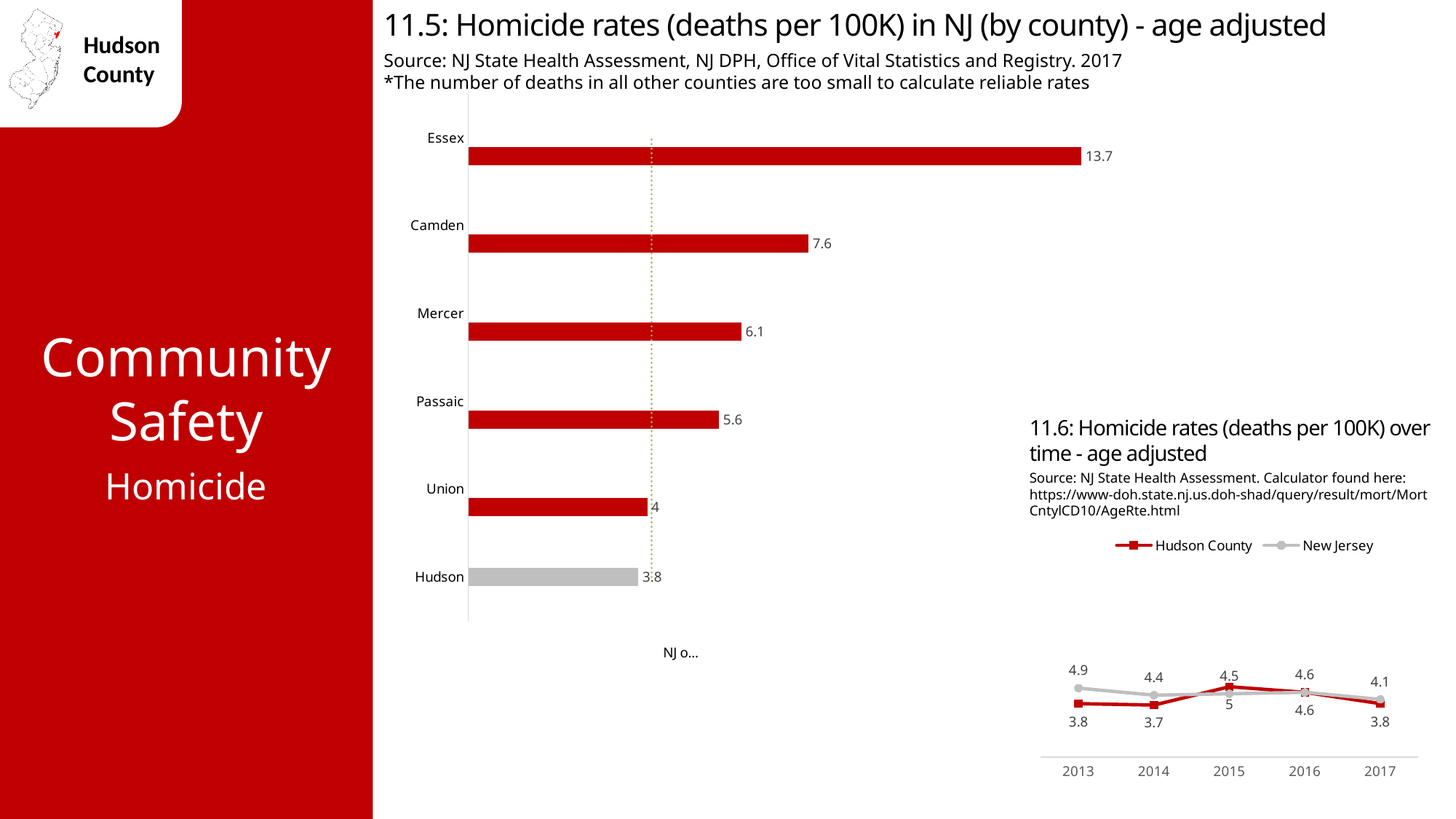
In chart 11.6 (homicide rates over time), how many series does the legend list? 2 In chart 11.5 (homicide rates by county), which county has the highest homicide rate? Essex What type of chart is chart 11.5 (homicide rates by county)? Bar chart In chart 11.5 (homicide rates by county), how many counties are shown? 6 In chart 11.6 (homicide rates over time), what is the difference between the New Jersey and Hudson County rates in 2014? 0.7 In chart 11.6 (homicide rates over time), what was the New Jersey homicide rate in 2013? 4.9 In chart 11.6 (homicide rates over time), which was higher in 2017, Hudson County or New Jersey? New Jersey In chart 11.5 (homicide rates by county), what is the homicide rate for Hudson? 3.8 In chart 11.5 (homicide rates by county), which county has the lowest homicide rate? Hudson In chart 11.5 (homicide rates by county), what is the homicide rate for Essex? 13.7 In chart 11.5 (homicide rates by county), what is the difference between the rates for Camden and Mercer? 1.5 In chart 11.6 (homicide rates over time), what was the Hudson County homicide rate in 2015? 5